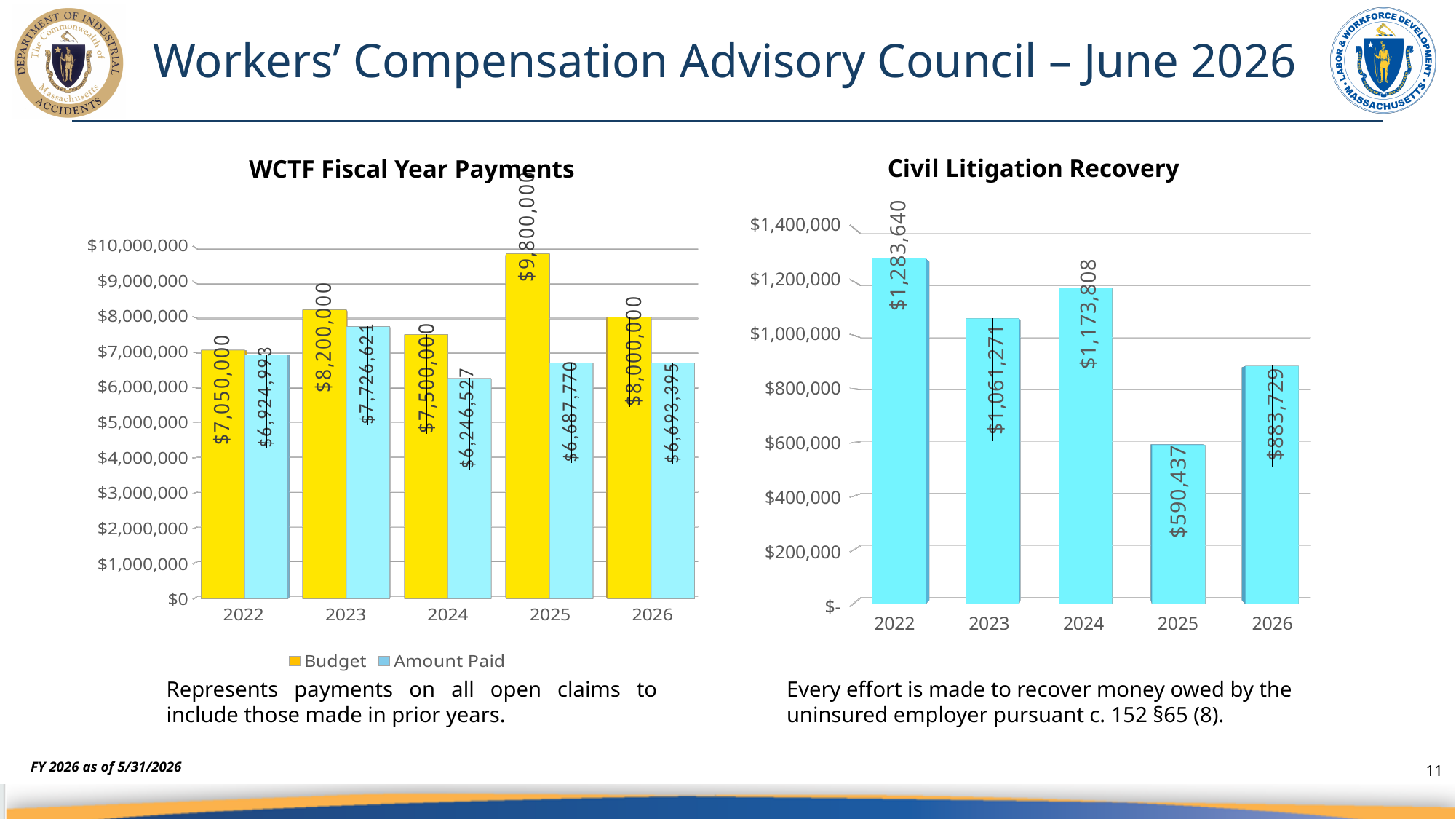
What kind of chart is the Civil Litigation Recovery chart? Bar chart In the Civil Litigation Recovery chart, how many years are shown on the x axis? 5 In the WCTF Fiscal Year Payments chart, how many series does the legend list? 2 In the Civil Litigation Recovery chart, what is the value for 2026? $883,729 In the WCTF Fiscal Year Payments chart, what is the Budget value for 2025? $9,800,000 In the WCTF Fiscal Year Payments chart, which year has the highest Budget? 2025 In the Civil Litigation Recovery chart, which year has the lowest recovery? 2025 In the WCTF Fiscal Year Payments chart, which is larger for 2022: the Budget or the Amount Paid? Budget In the WCTF Fiscal Year Payments chart, what is the Amount Paid for 2023? $7,726,621 In the WCTF Fiscal Year Payments chart, which year has the lowest Amount Paid? 2024 In the WCTF Fiscal Year Payments chart, what is the difference between the Budget and the Amount Paid for 2025? $3,112,230 In the Civil Litigation Recovery chart, what is the difference between the 2022 and 2025 values? $693,203